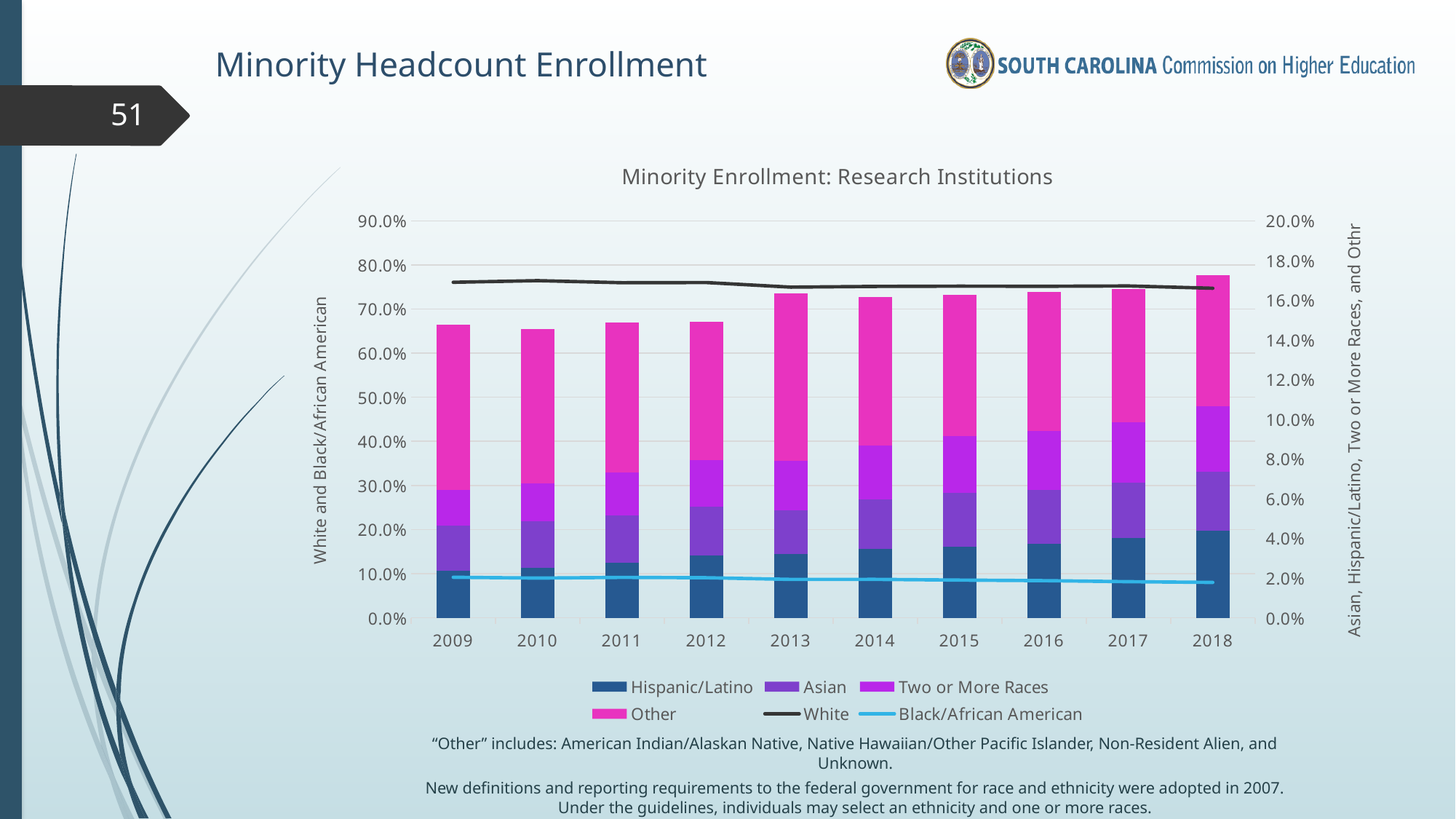
Which year has the tallest stacked bar in the chart? 2018 Is the stacked bar for 2018 taller or shorter than the stacked bar for 2009? taller How many series does the chart's legend list? 6 What kind of chart is shown on the slide? combination stacked bar and line chart What is the title of the chart on the slide? Minority Enrollment: Research Institutions Does the White line rise or fall from 2009 to 2018? fall Which two series in the chart are drawn as lines rather than bars? White and Black/African American Is the value of the White line in 2009 greater or less than 70.0% on the left axis? greater Is the value of the Black/African American line in 2018 greater or less than 20.0% on the left axis? less How many years are shown along the x axis of the chart? 10 Do the stacked bar totals generally rise or fall from 2009 to 2018? rise Is the Hispanic/Latino segment larger in 2018 or in 2009? 2018